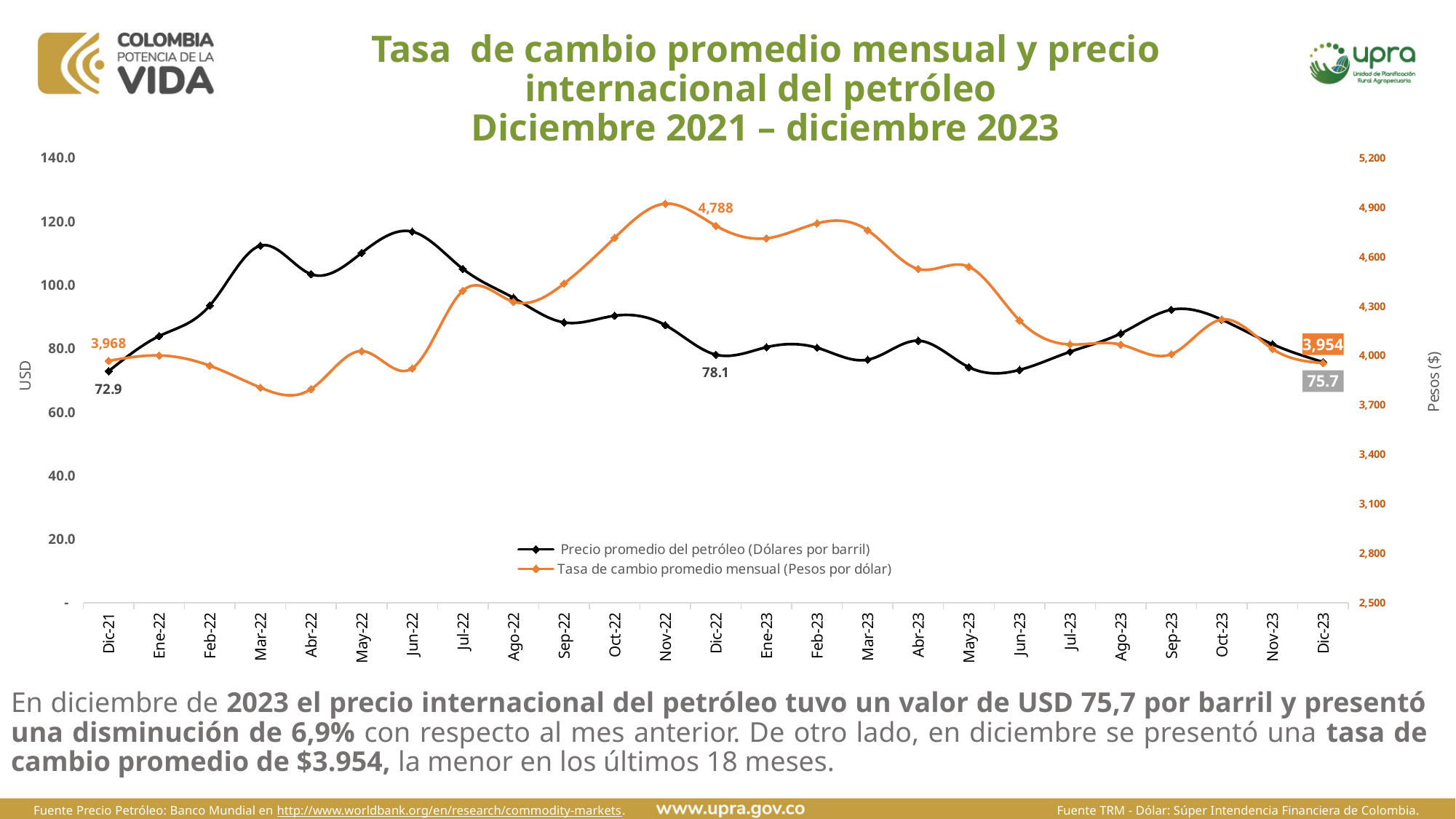
In which month does the exchange rate series reach its highest point? Nov-22 Which is larger, the oil price labeled for Dic-22 or the one labeled for Dic-23? Dic-22 What is the average monthly exchange rate (pesos per dollar) labeled for Dic-21? 3,968 What is the difference between the oil price labeled for Dic-22 and the one labeled for Dic-21? 5.2 What is the average monthly exchange rate labeled for Dic-23? 3,954 What type of chart is shown on the slide? line chart What is the average oil price (USD per barrel) labeled for Dic-21? 72.9 What is the average oil price labeled for Dic-22? 78.1 Is the oil price for Mar-22 greater or less than 100.0? greater How many months are plotted along the x axis? 25 How many series does the legend list? 2 What is the average oil price labeled for Dic-23? 75.7